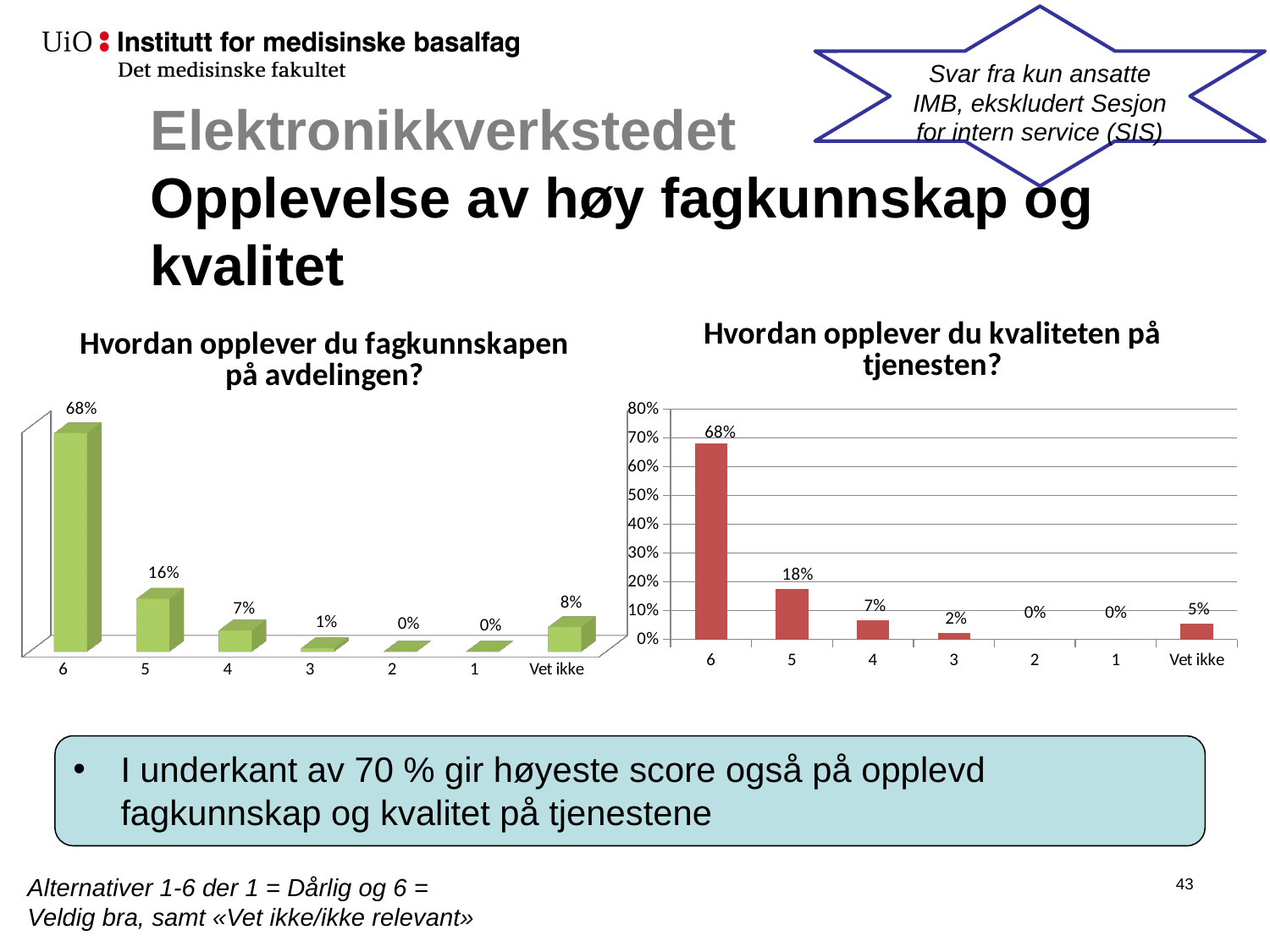
How many categories are shown on the x axis of the chart 'Hvordan opplever du fagkunnskapen på avdelingen?'? 7 In the chart 'Hvordan opplever du kvaliteten på tjenesten?', which category has the highest value? 6 What kind of chart is 'Hvordan opplever du kvaliteten på tjenesten?'? Bar chart In the chart 'Hvordan opplever du fagkunnskapen på avdelingen?', what is the value for 'Vet ikke'? 8% In the chart 'Hvordan opplever du fagkunnskapen på avdelingen?', what is the value for category 6? 68% What colour are the bars in the chart 'Hvordan opplever du kvaliteten på tjenesten?'? Red In the chart 'Hvordan opplever du kvaliteten på tjenesten?', what is the value for category 5? 18% In the chart 'Hvordan opplever du kvaliteten på tjenesten?', is the value for category 6 greater or less than 60%? greater In the chart 'Hvordan opplever du kvaliteten på tjenesten?', what is the value for category 3? 2% In the chart 'Hvordan opplever du fagkunnskapen på avdelingen?', what is the difference between the values for category 6 and category 5? 52% In the chart 'Hvordan opplever du kvaliteten på tjenesten?', which is larger: the value for category 4 or the value for 'Vet ikke'? 4 In the chart 'Hvordan opplever du fagkunnskapen på avdelingen?', what is the value for category 5? 16%